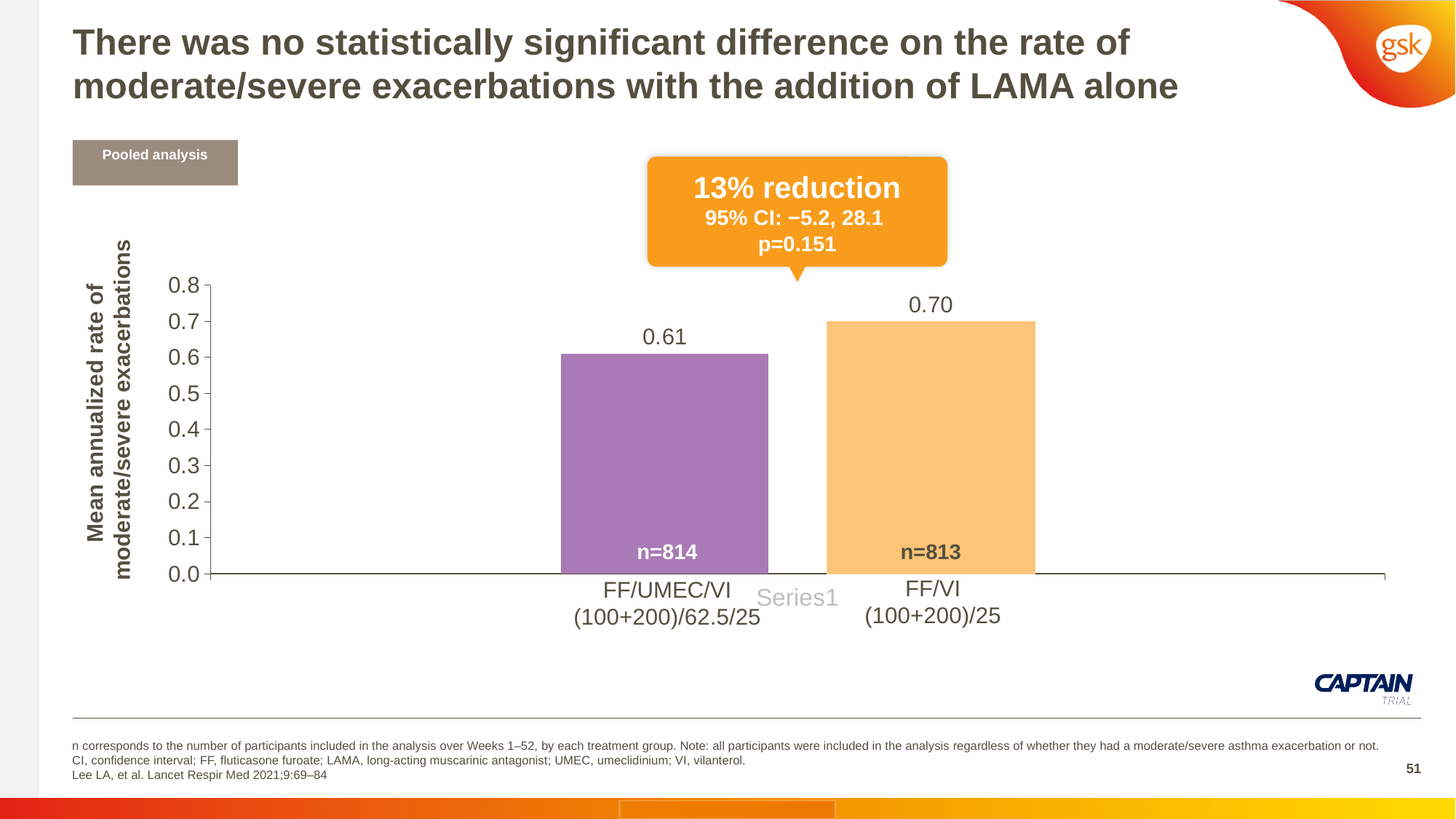
What is the mean annualized rate of moderate/severe exacerbations for FF/UMEC/VI (100+200)/62.5/25? 0.61 What is the mean annualized rate of moderate/severe exacerbations for FF/VI (100+200)/25? 0.70 What is the number of participants (n) in the FF/UMEC/VI (100+200)/62.5/25 group? n=814 Is the value for FF/VI (100+200)/25 greater or less than 0.8? less What is the label of the y-axis? Mean annualized rate of moderate/severe exacerbations Which treatment group has the higher mean annualized rate of moderate/severe exacerbations? FF/VI (100+200)/25 How many treatment groups are plotted in the chart? 2 What kind of chart is shown on the slide? bar chart What is the difference between the exacerbation rates for FF/VI (100+200)/25 and FF/UMEC/VI (100+200)/62.5/25? 0.09 Which treatment group has the lower mean annualized rate of moderate/severe exacerbations? FF/UMEC/VI (100+200)/62.5/25 What percentage reduction is shown in the callout above the bars? 13% reduction Is the exacerbation rate for FF/UMEC/VI (100+200)/62.5/25 larger or smaller than that for FF/VI (100+200)/25? smaller